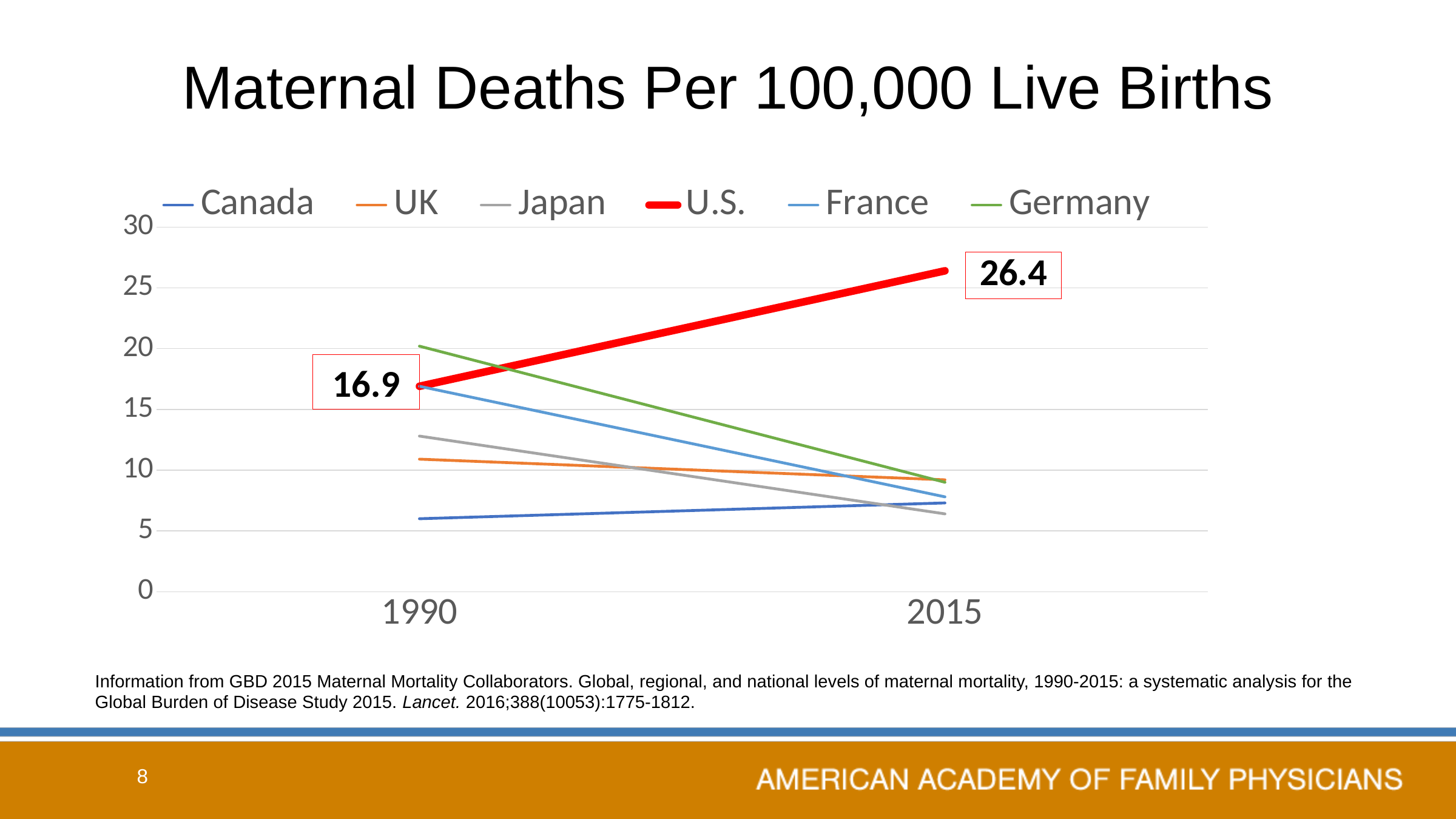
What is the U.S. value for 1990? 16.9 What is the U.S. value for 2015? 26.4 Which series is drawn with the thick red line? U.S. What kind of chart is shown on the slide? Line chart Does the Germany line rise or fall from 1990 to 2015? Falls Is the value for Japan in 2015 greater or less than 10? less By how much did the U.S. value increase from 1990 to 2015? 9.5 Does the U.S. line rise or fall from 1990 to 2015? Rises Which country has the highest value in 1990? Germany Which country has the lowest value in 1990? Canada Which country has the highest value in 2015? U.S. How many series does the legend list? 6